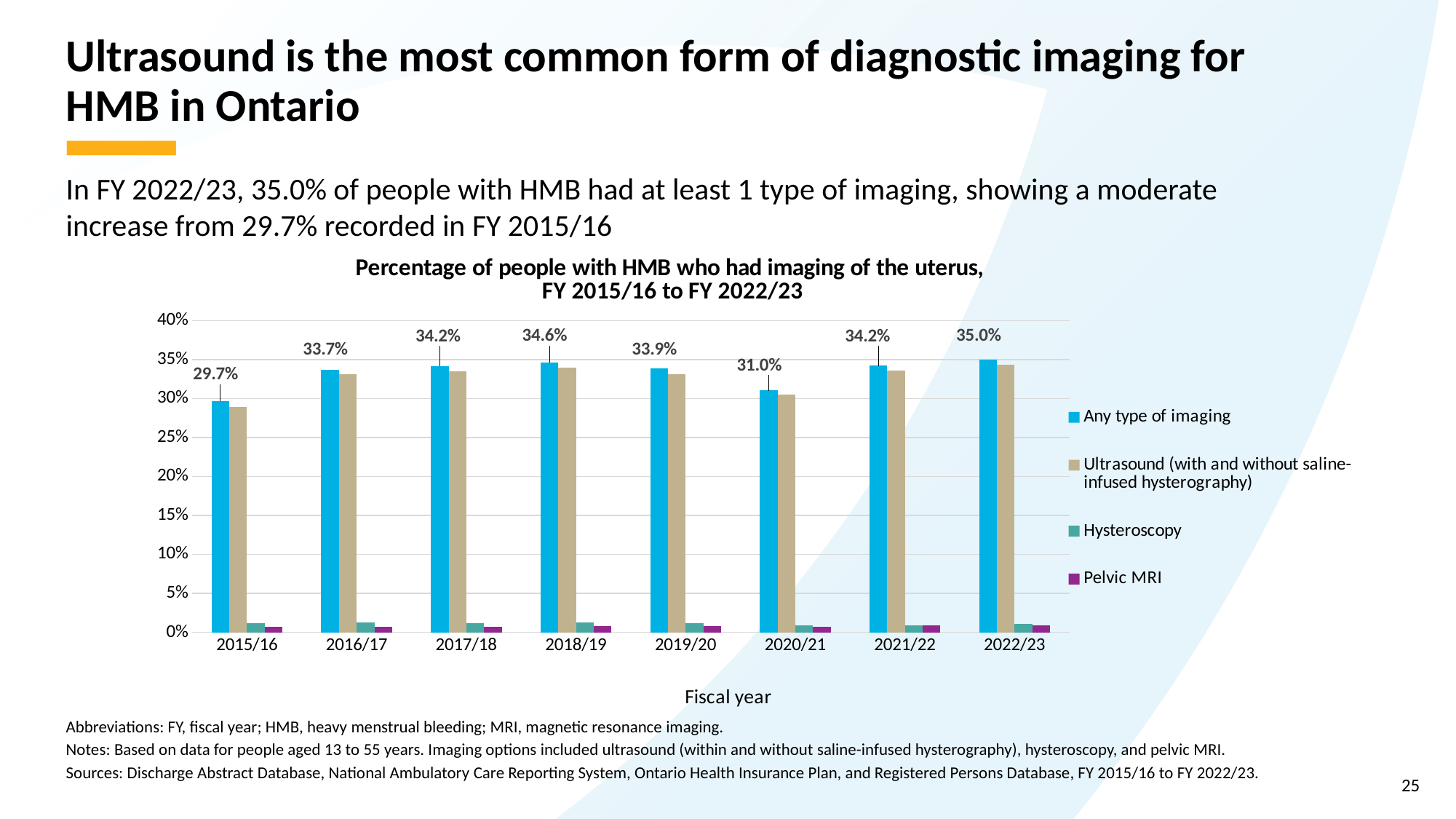
What is the difference between the Any type of imaging values for FY 2022/23 and FY 2015/16? 5.3 percentage points Is the value for Hysteroscopy in FY 2022/23 greater or less than 5%? less How many fiscal years are shown on the x axis? 8 What is the value for Any type of imaging in FY 2022/23? 35.0% In which fiscal year is the value for Any type of imaging lowest? 2015/16 What is the value for Any type of imaging in FY 2020/21? 31.0% How many series does the legend list? 4 Which is larger for Any type of imaging: FY 2018/19 or FY 2020/21? 2018/19 In which fiscal year is the value for Any type of imaging highest? 2022/23 What kind of chart is shown on the slide? Bar chart What is the value for Any type of imaging in FY 2015/16? 29.7% Is the value for Ultrasound (with and without saline-infused hysterography) in FY 2015/16 greater or less than 30%? less